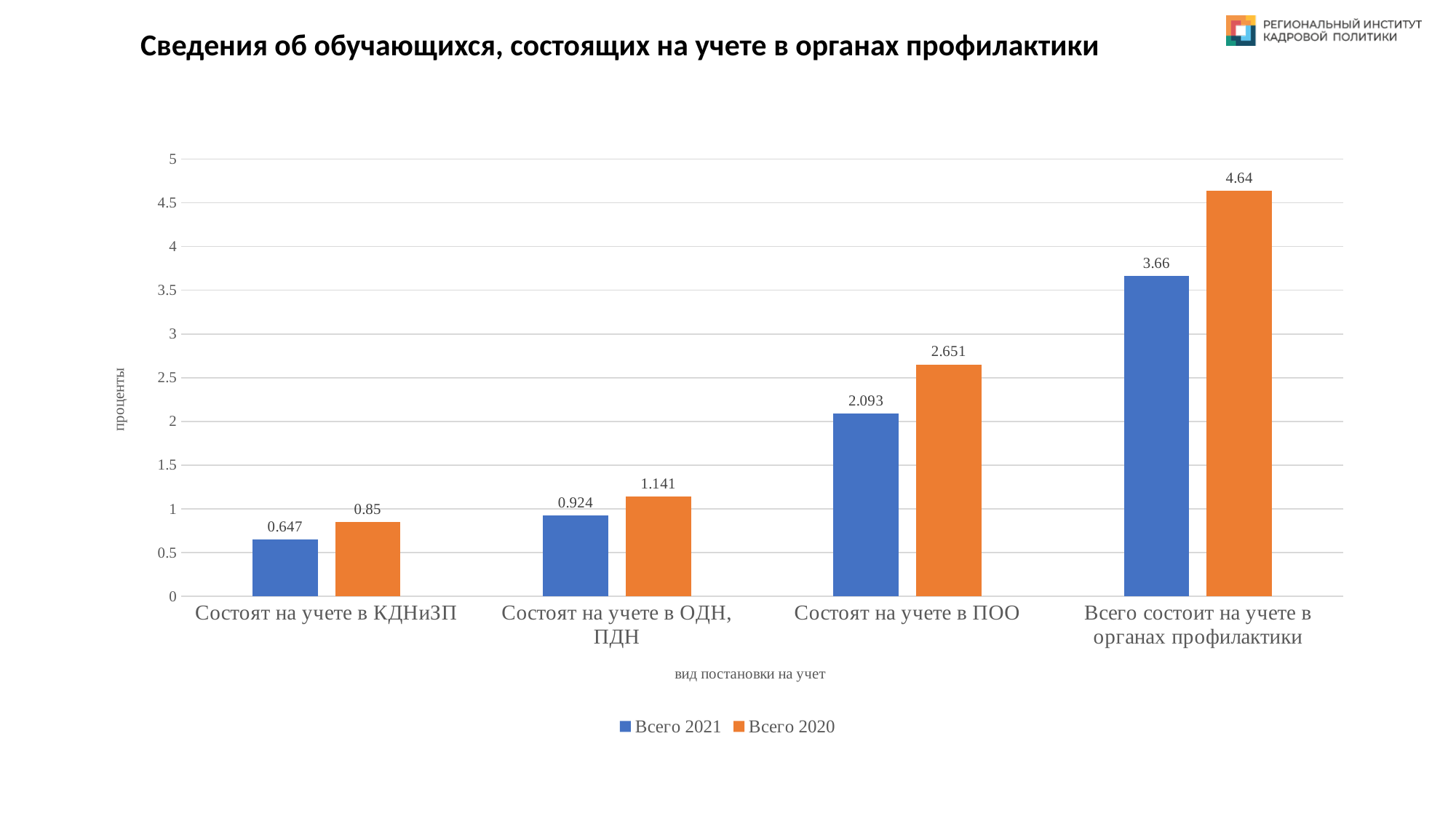
What kind of chart is shown on the slide? Bar chart In the category "Состоят на учете в ПОО", which series has the larger value, "Всего 2021" or "Всего 2020"? Всего 2020 Which category has the highest value for the "Всего 2021" series? Всего состоит на учете в органах профилактики What is the value for "Всего 2020" in the category "Всего состоит на учете в органах профилактики"? 4.64 What is the value for "Всего 2021" in the category "Состоят на учете в КДНиЗП"? 0.647 What is the label of the y axis? проценты What is the value for "Всего 2020" in the category "Состоят на учете в ПОО"? 2.651 How many categories are shown on the x axis? 4 What is the value for "Всего 2021" in the category "Состоят на учете в ОДН, ПДН"? 0.924 How many series does the legend list? 2 What is the difference between the "Всего 2020" and "Всего 2021" values in the category "Всего состоит на учете в органах профилактики"? 0.98 Which category has the lowest value for the "Всего 2020" series? Состоят на учете в КДНиЗП